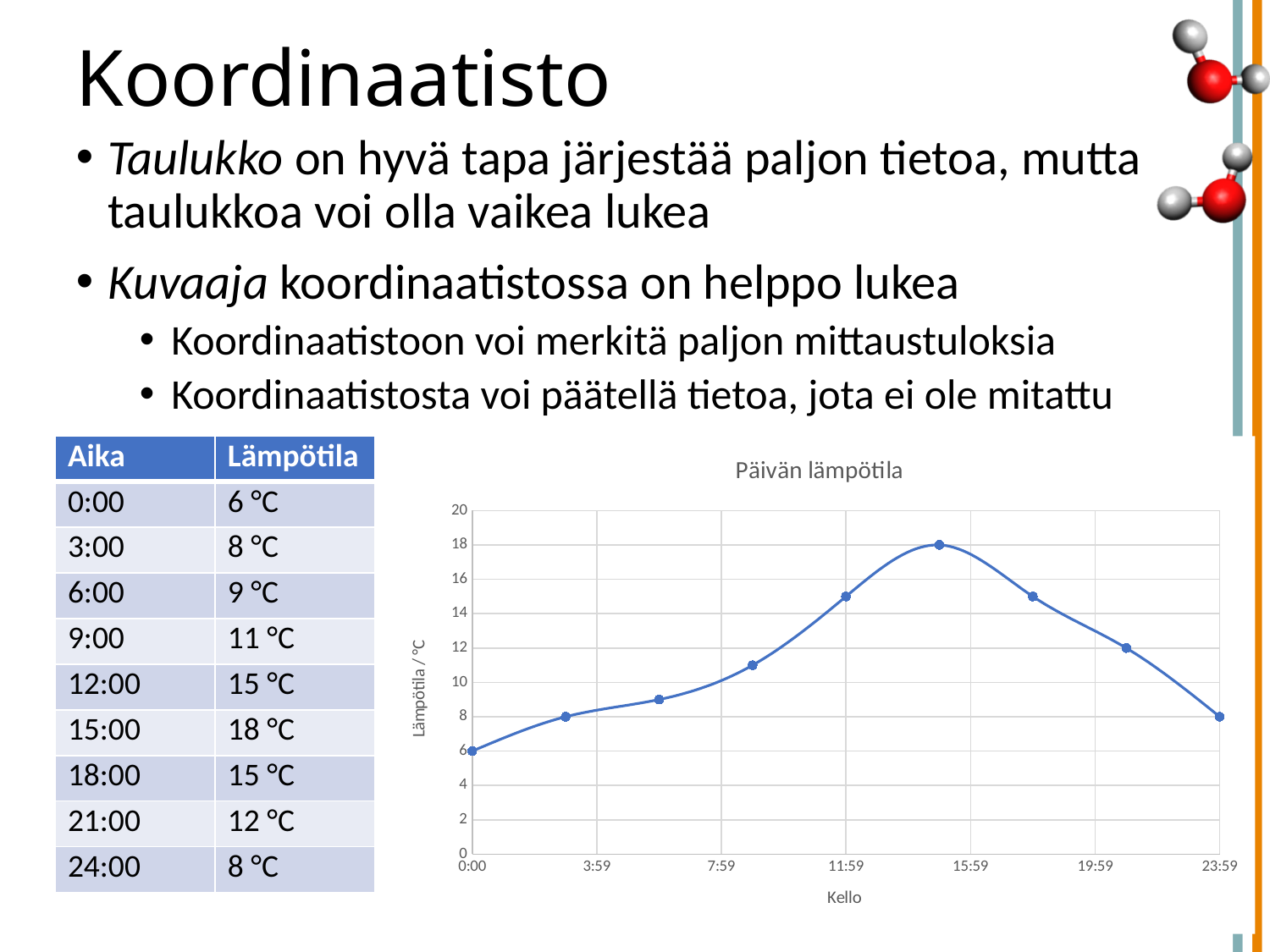
What is the title of the chart? Päivän lämpötila Is the temperature at 9:00 greater or less than 10? greater At what time is the temperature lowest in the chart? 0:00 Which is higher in the chart, the temperature at 12:00 or at 21:00? 12:00 What kind of chart is shown on the slide? Line chart At what time does the temperature reach its highest value in the chart? 15:00 What is the difference between the highest and lowest temperatures in the chart? 12 °C How does the temperature change from 15:00 to the end of the day in the chart? It falls How many data points are plotted on the line in the chart? 9 What is the label of the vertical axis of the chart? Lämpötila / °C What is the temperature at 15:00 according to the chart? 18 °C What is the temperature at 0:00 according to the chart? 6 °C